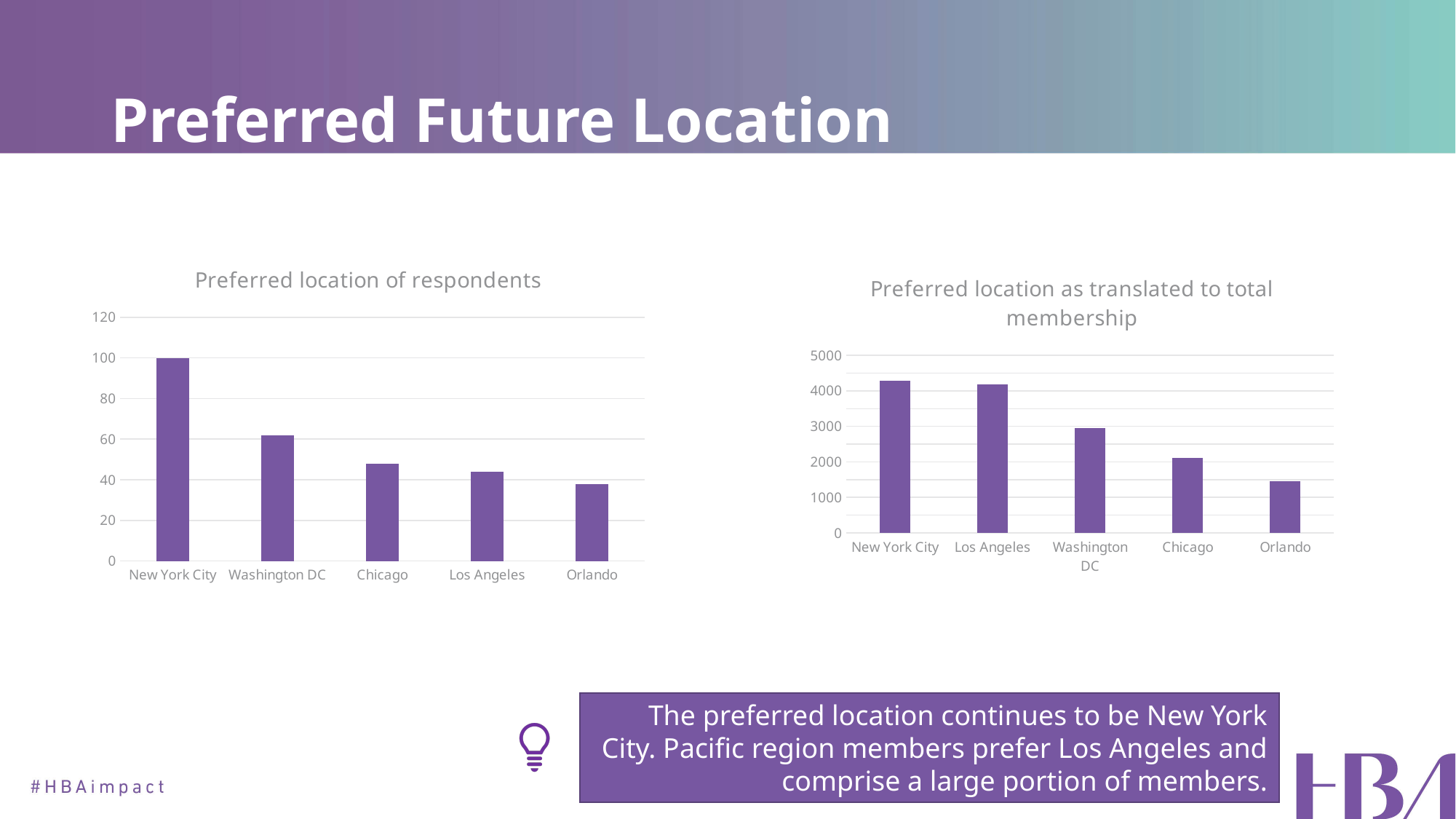
In the 'Preferred location as translated to total membership' chart, which location has the lowest value? Orlando In the 'Preferred location of respondents' chart, do the values rise or fall from left to right? fall In the 'Preferred location of respondents' chart, which location has the lowest value? Orlando In the 'Preferred location as translated to total membership' chart, is the value for Washington DC greater or less than 2000? greater In the 'Preferred location of respondents' chart, which is larger, the value for Washington DC or the value for Los Angeles? Washington DC In the 'Preferred location of respondents' chart, is the value for Chicago greater or less than 40? greater In the 'Preferred location of respondents' chart, is the value for Washington DC greater or less than 80? less How many locations are shown in the 'Preferred location of respondents' chart? 5 In the 'Preferred location of respondents' chart, which location has the highest value? New York City What kind of chart is 'Preferred location of respondents'? bar chart What is the title of the chart on the right side of the slide? Preferred location as translated to total membership In the 'Preferred location as translated to total membership' chart, which is larger, the value for Los Angeles or the value for Chicago? Los Angeles